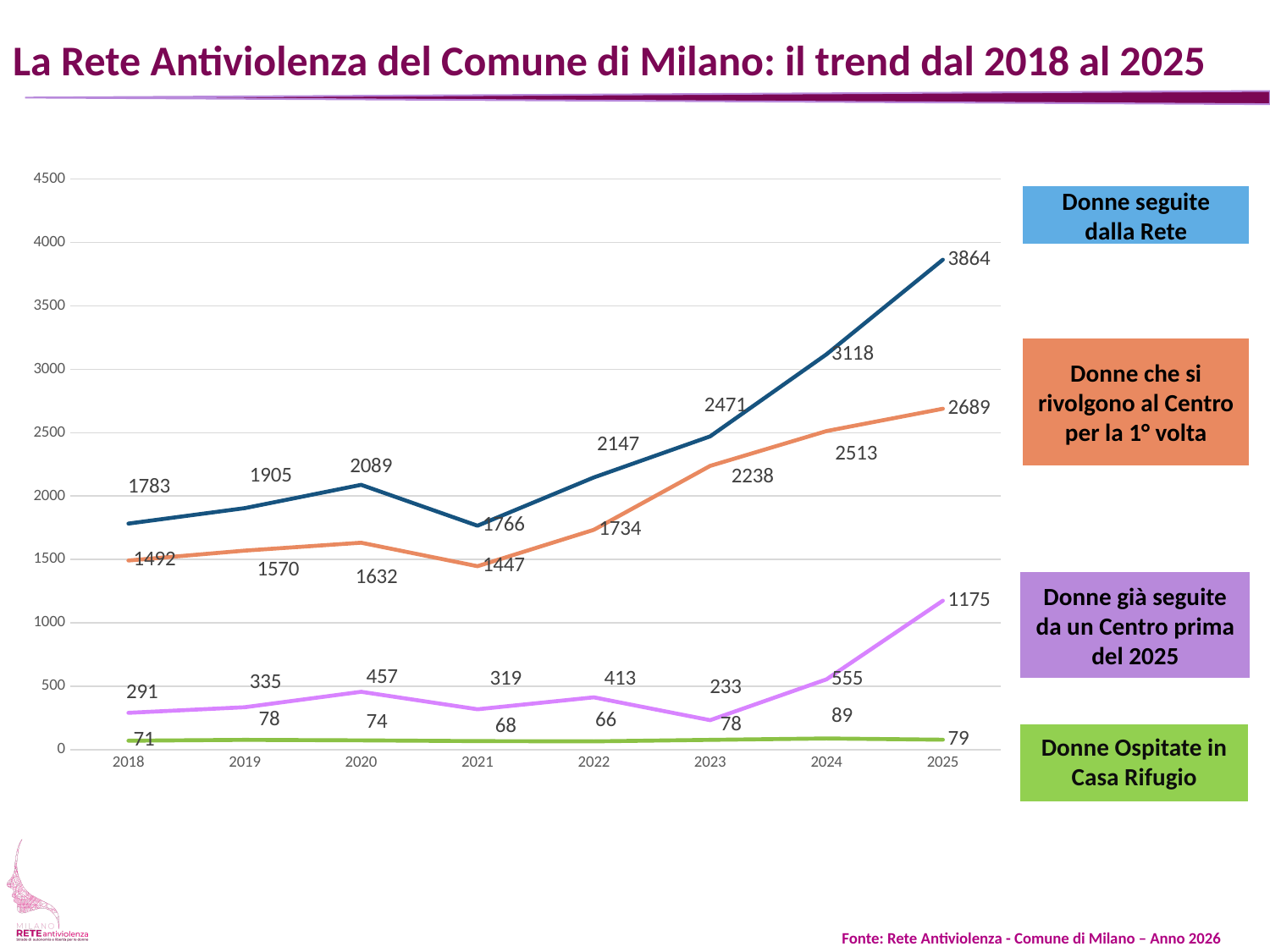
What is the value for 'Donne che si rivolgono al Centro per la 1° volta' in 2021? 1447 How many series does the chart show? 4 What kind of chart is shown on the slide? line chart What is the difference between 'Donne seguite dalla Rete' in 2025 and in 2024? 746 Is the value for 'Donne che si rivolgono al Centro per la 1° volta' in 2024 greater or less than 2500? greater In which year is 'Donne già seguite da un Centro prima del 2025' highest? 2025 How many years are plotted along the x axis? 8 Which is larger: 'Donne già seguite da un Centro prima del 2025' in 2020 or in 2022? 2020 In which year is 'Donne seguite dalla Rete' lowest? 2021 What is the title of the chart on the slide? La Rete Antiviolenza del Comune di Milano: il trend dal 2018 al 2025 What is the value for 'Donne seguite dalla Rete' in 2025? 3864 What is the value for 'Donne Ospitate in Casa Rifugio' in 2024? 89